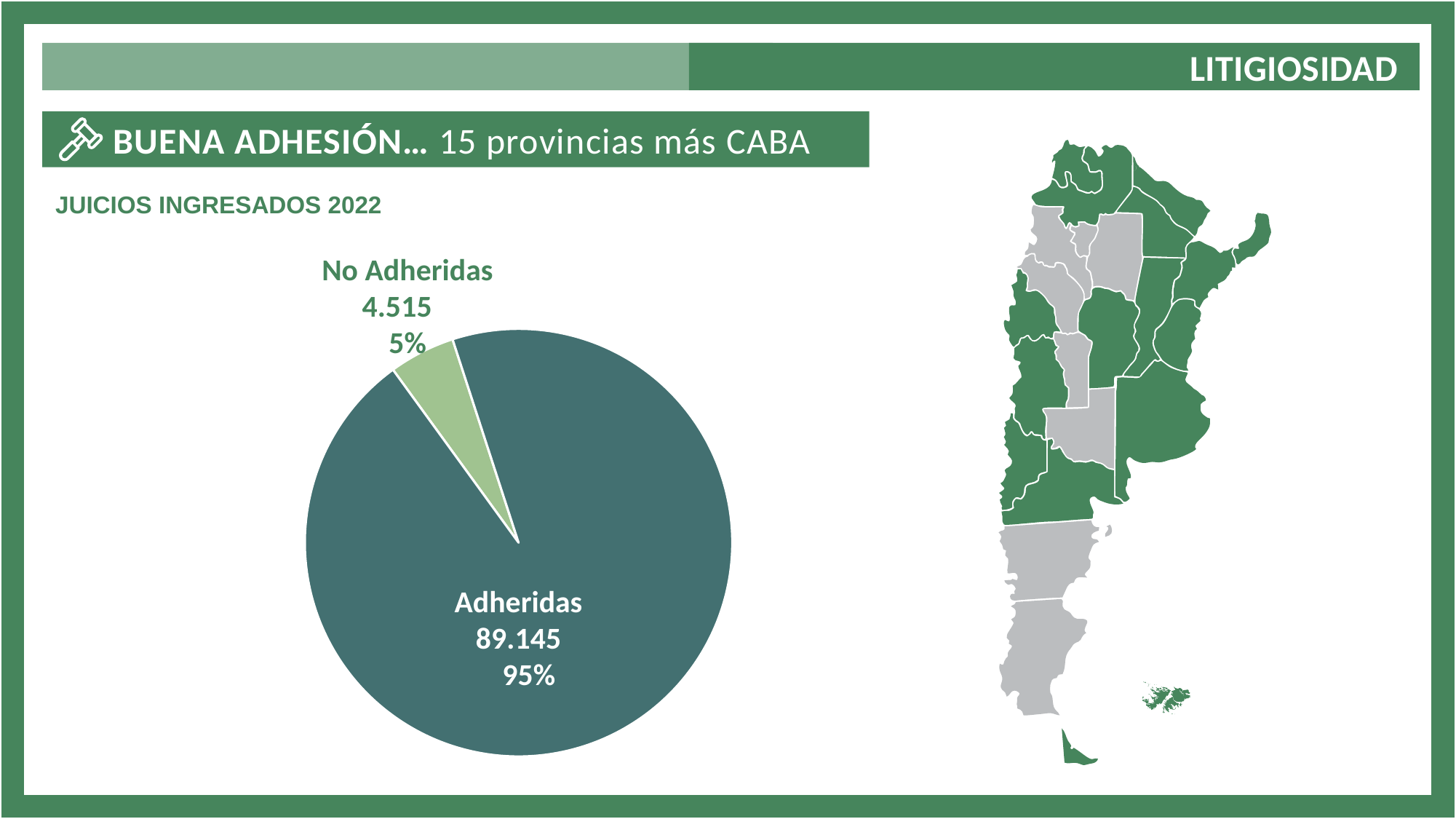
What share of the pie does No Adheridas represent? 5% What is the difference between the Adheridas and No Adheridas values in the pie chart? 84.630 Which slice of the pie chart is the largest? Adheridas Which slice of the pie chart is the smallest? No Adheridas What is the title of the pie chart? JUICIOS INGRESADOS 2022 What is the value for Adheridas in the pie chart? 89.145 What colour is the No Adheridas slice of the pie chart? light green What share of the pie does Adheridas represent? 95% Which is larger in the pie chart, Adheridas or No Adheridas? Adheridas How many slices does the pie chart have? 2 What is the value for No Adheridas in the pie chart? 4.515 What kind of chart is shown under "JUICIOS INGRESADOS 2022"? pie chart